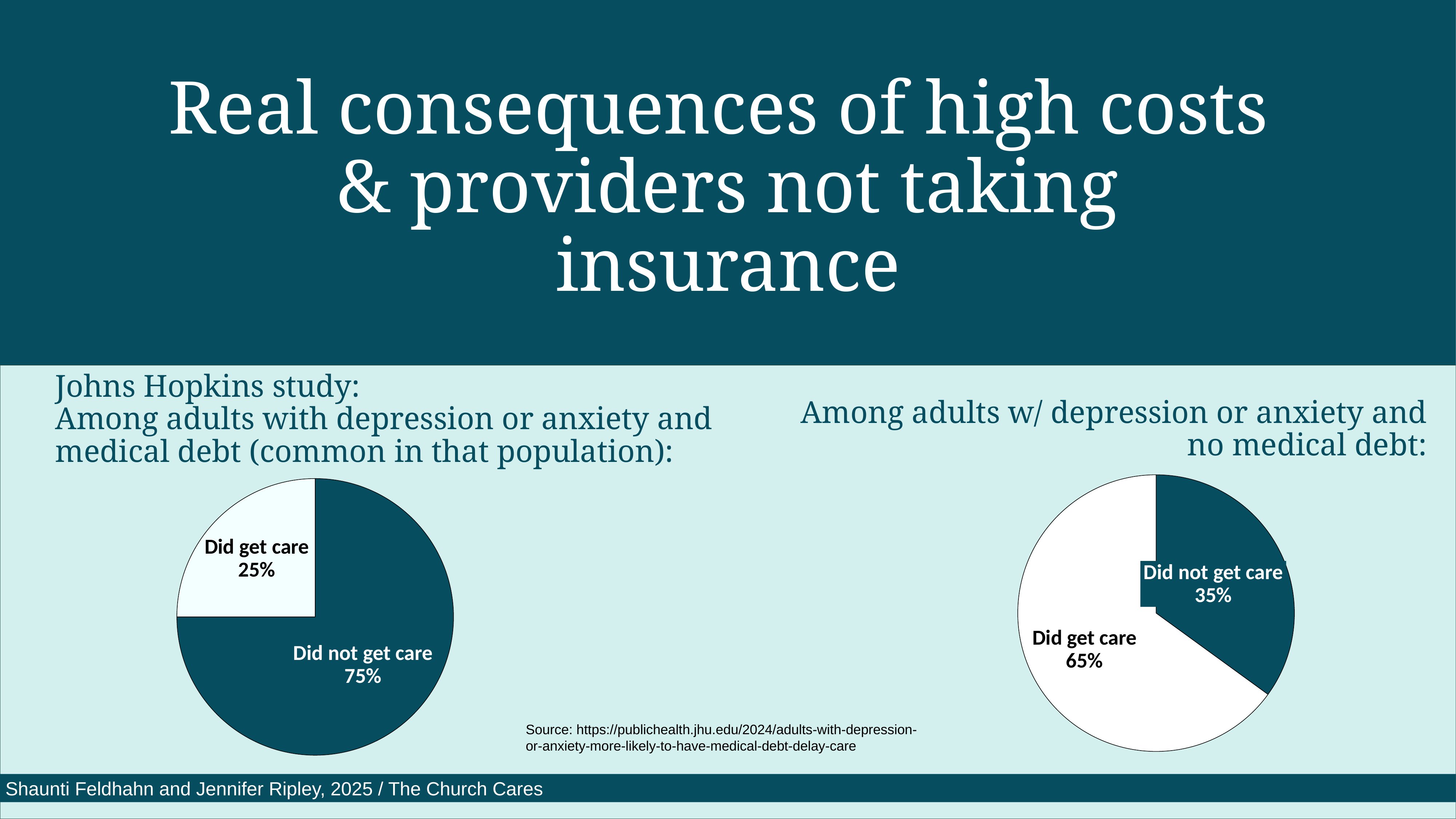
How many slices does the left pie chart (adults with medical debt) have? 2 In the right pie chart (adults with depression or anxiety and no medical debt), what percentage did not get care? 35% Which is larger: the 'Did not get care' share in the left pie chart (with medical debt) or the 'Did not get care' share in the right pie chart (no medical debt)? Left pie chart (with medical debt) What type of chart is used on the right side of the slide for adults with no medical debt? Pie chart In the left pie chart (adults with medical debt), what is the difference between the 'Did not get care' and 'Did get care' shares? 50% How many pie charts are shown on the slide? 2 In the right pie chart (adults with depression or anxiety and no medical debt), what percentage did get care? 65% In the right pie chart (adults with no medical debt), which slice is the smallest? Did not get care In the right pie chart (adults with no medical debt), what is the difference between the 'Did get care' and 'Did not get care' shares? 30% In the left pie chart (adults with depression or anxiety and medical debt), what percentage did not get care? 75% In the left pie chart (adults with depression or anxiety and medical debt), what percentage did get care? 25% In the left pie chart (adults with medical debt), which slice is the largest? Did not get care